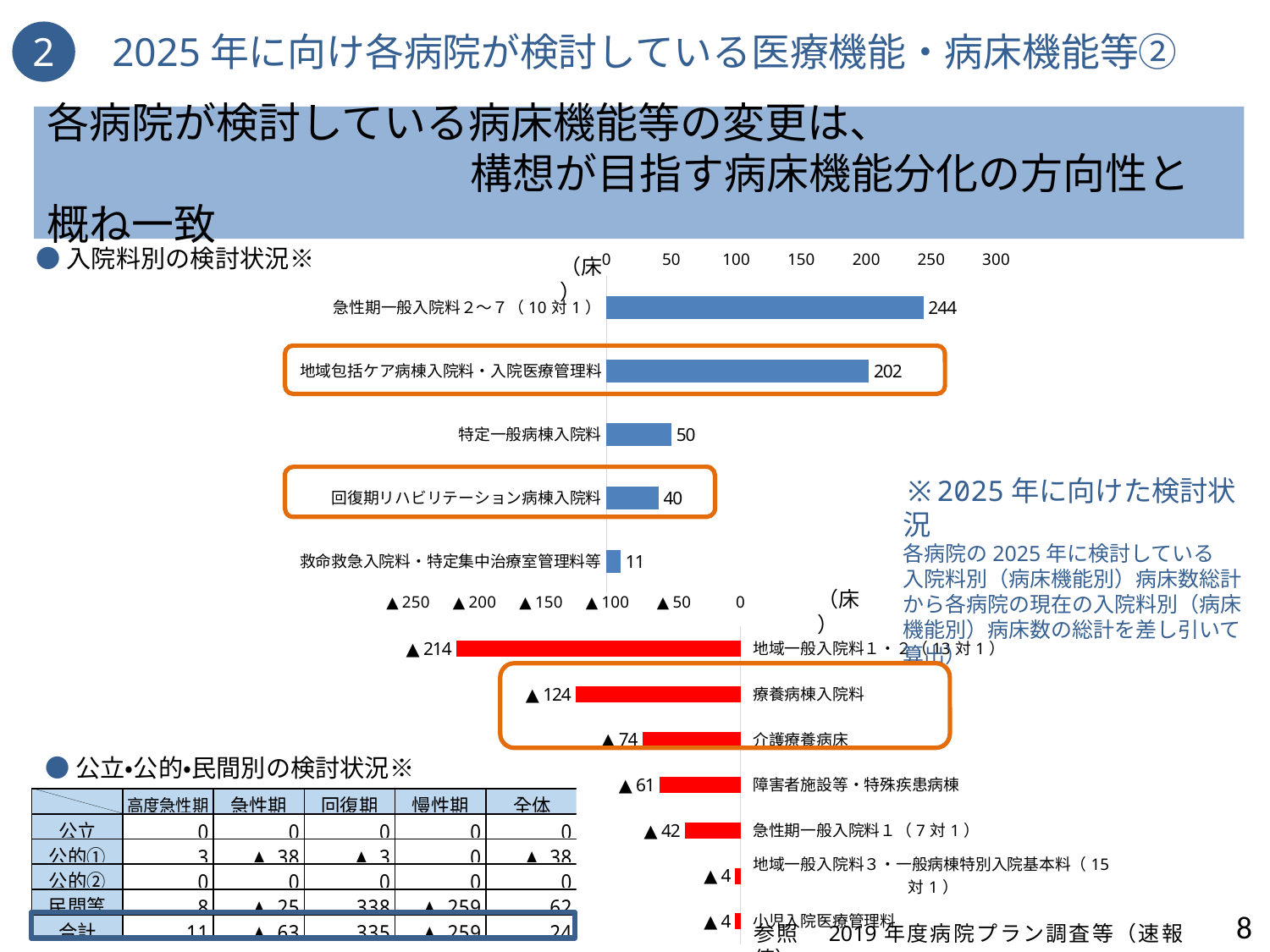
In the lower chart (red bars), what is the value for 療養病棟入院料? ▲124 In the upper chart (blue bars), which category has the highest value? 急性期一般入院料２～７（10対1） In the lower chart (red bars), what is the value for 介護療養病床? ▲74 How many categories are plotted in the lower chart (red bars)? 7 In the upper chart (blue bars), what is the value for 急性期一般入院料２～７（10対1）? 244 In the lower chart (red bars), which category has the largest decrease (longest bar)? 地域一般入院料１・２（13対1） In the upper chart (blue bars), what is the difference between the values for 特定一般病棟入院料 and 回復期リハビリテーション病棟入院料? 10 In the upper chart (blue bars), which category has the lowest value? 救命救急入院料・特定集中治療室管理料等 In the upper chart (blue bars), what is the value for 地域包括ケア病棟入院料・入院医療管理料? 202 What type of chart is the upper chart on the slide? Bar chart In the lower chart (red bars), which bar is longer: 障害者施設等・特殊疾患病棟 or 急性期一般入院料１（7対1）? 障害者施設等・特殊疾患病棟 How many categories are plotted in the upper chart (blue bars)? 5